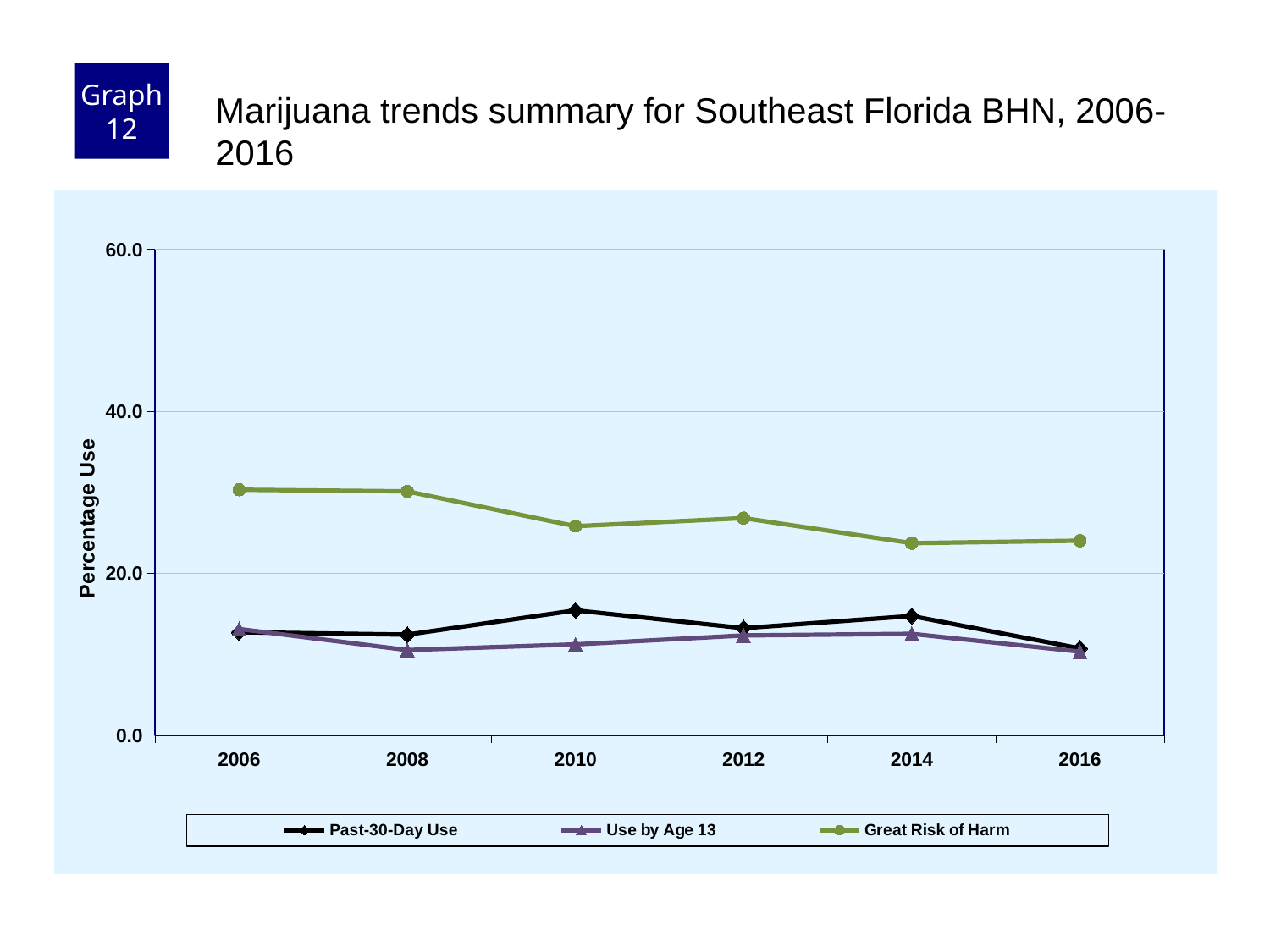
Which series has the higher value in 2010, Past-30-Day Use or Use by Age 13? Past-30-Day Use What is the label on the y axis? Percentage Use Does the Great Risk of Harm series generally rise or fall from 2006 to 2016? Fall How many series does the legend list? 3 Which series has the higher value in 2012, Great Risk of Harm or Past-30-Day Use? Great Risk of Harm Is the value for Great Risk of Harm in 2006 greater or less than 20? greater Which series is drawn in green? Great Risk of Harm Is the value for Past-30-Day Use in 2010 greater or less than 20? less What kind of chart is shown on the slide? Line chart In which year is Past-30-Day Use at its lowest? 2016 How many years are plotted along the x axis? 6 Is the value for Great Risk of Harm in 2016 greater or less than 40? less